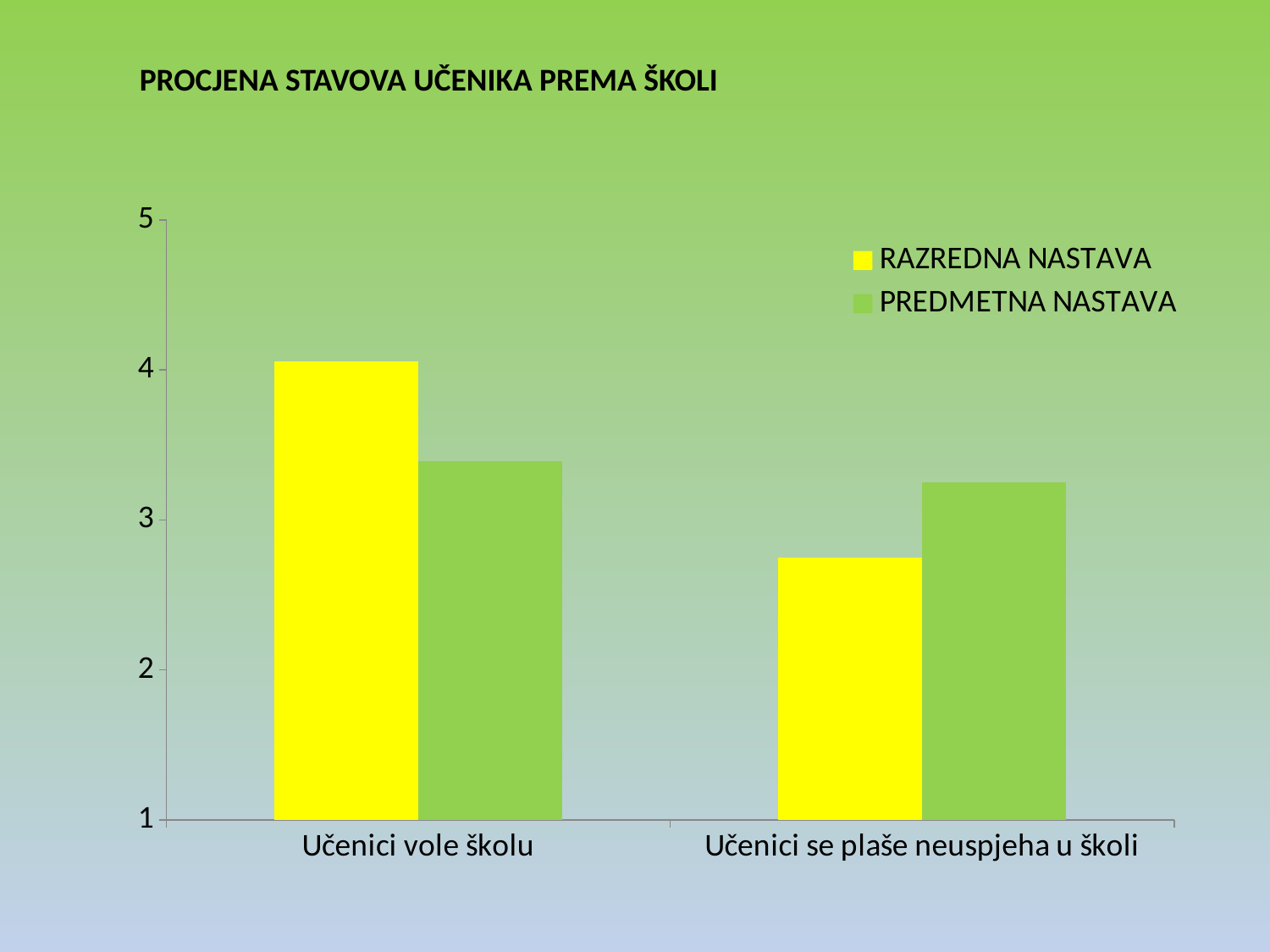
Is the RAZREDNA NASTAVA value for "Učenici se plaše neuspjeha u školi" greater or less than 3? less Is the PREDMETNA NASTAVA value for "Učenici se plaše neuspjeha u školi" greater or less than 3? greater Which bar is the tallest in the chart? RAZREDNA NASTAVA for Učenici vole školu Is the RAZREDNA NASTAVA value for "Učenici vole školu" greater or less than 3? greater How many categories are shown on the x axis? 2 Which series is shown in yellow? RAZREDNA NASTAVA For "Učenici se plaše neuspjeha u školi", which series has the larger value, RAZREDNA NASTAVA or PREDMETNA NASTAVA? PREDMETNA NASTAVA What kind of chart is shown on the slide? bar chart For "Učenici vole školu", which series has the larger value, RAZREDNA NASTAVA or PREDMETNA NASTAVA? RAZREDNA NASTAVA How many series does the legend list? 2 What is the title of the chart? PROCJENA STAVOVA UČENIKA PREMA ŠKOLI